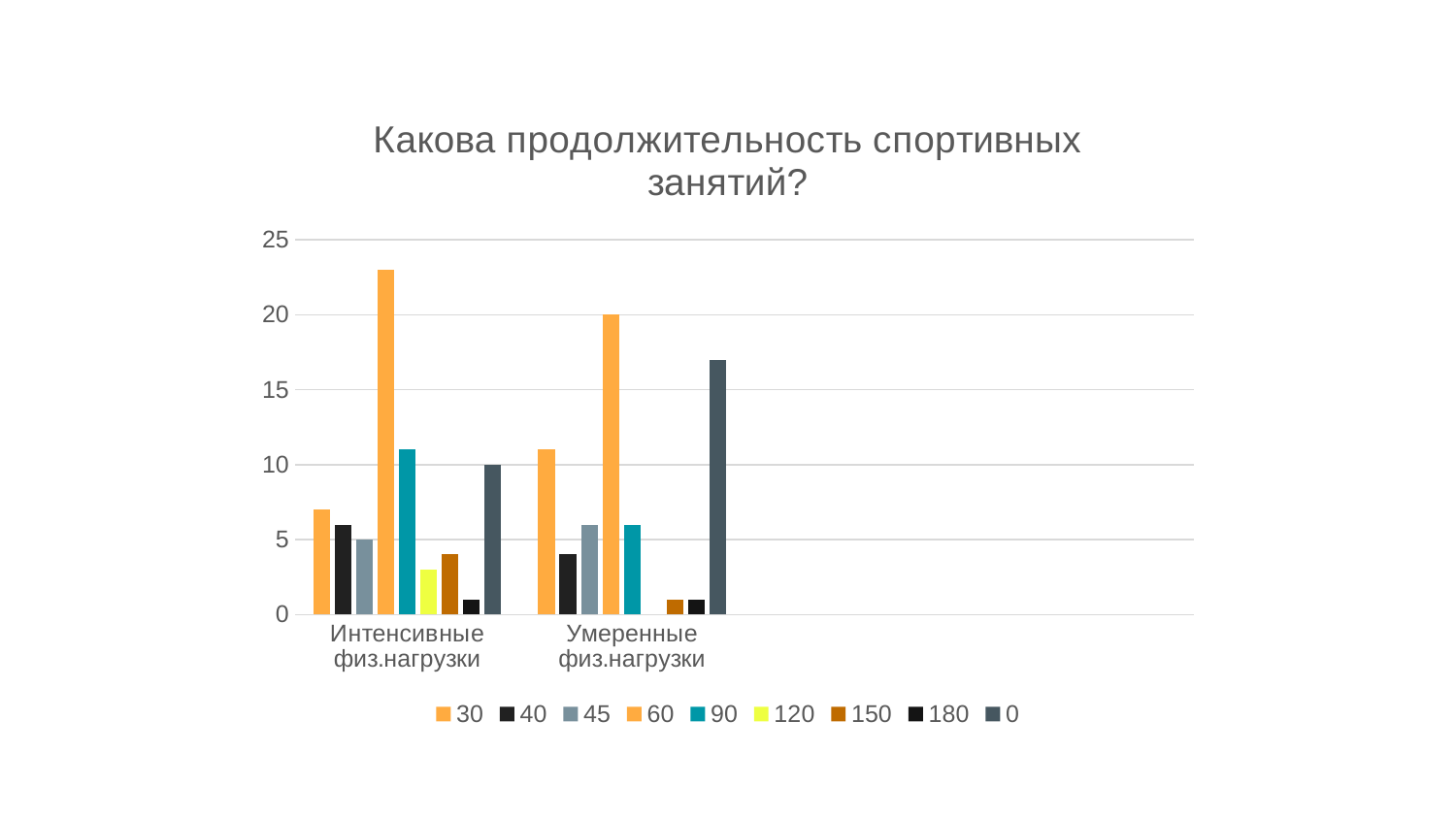
For the 60 series, which category has the larger value: Интенсивные физ.нагрузки or Умеренные физ.нагрузки? Интенсивные физ.нагрузки Is the value of the 30 series for Интенсивные физ.нагрузки greater or less than 10? less Which series has the highest bar for Умеренные физ.нагрузки? 60 For the 0 series, which category has the larger value: Интенсивные физ.нагрузки or Умеренные физ.нагрузки? Умеренные физ.нагрузки Is the value of the 0 series for Умеренные физ.нагрузки greater or less than 15? greater What kind of chart is shown on the slide? bar chart Is the value of the 60 series for Интенсивные физ.нагрузки greater or less than 20? greater How many categories are shown on the x axis? 2 What is the title of the chart? Какова продолжительность спортивных занятий? Which series has the highest bar for Интенсивные физ.нагрузки? 60 How many series does the legend list? 9